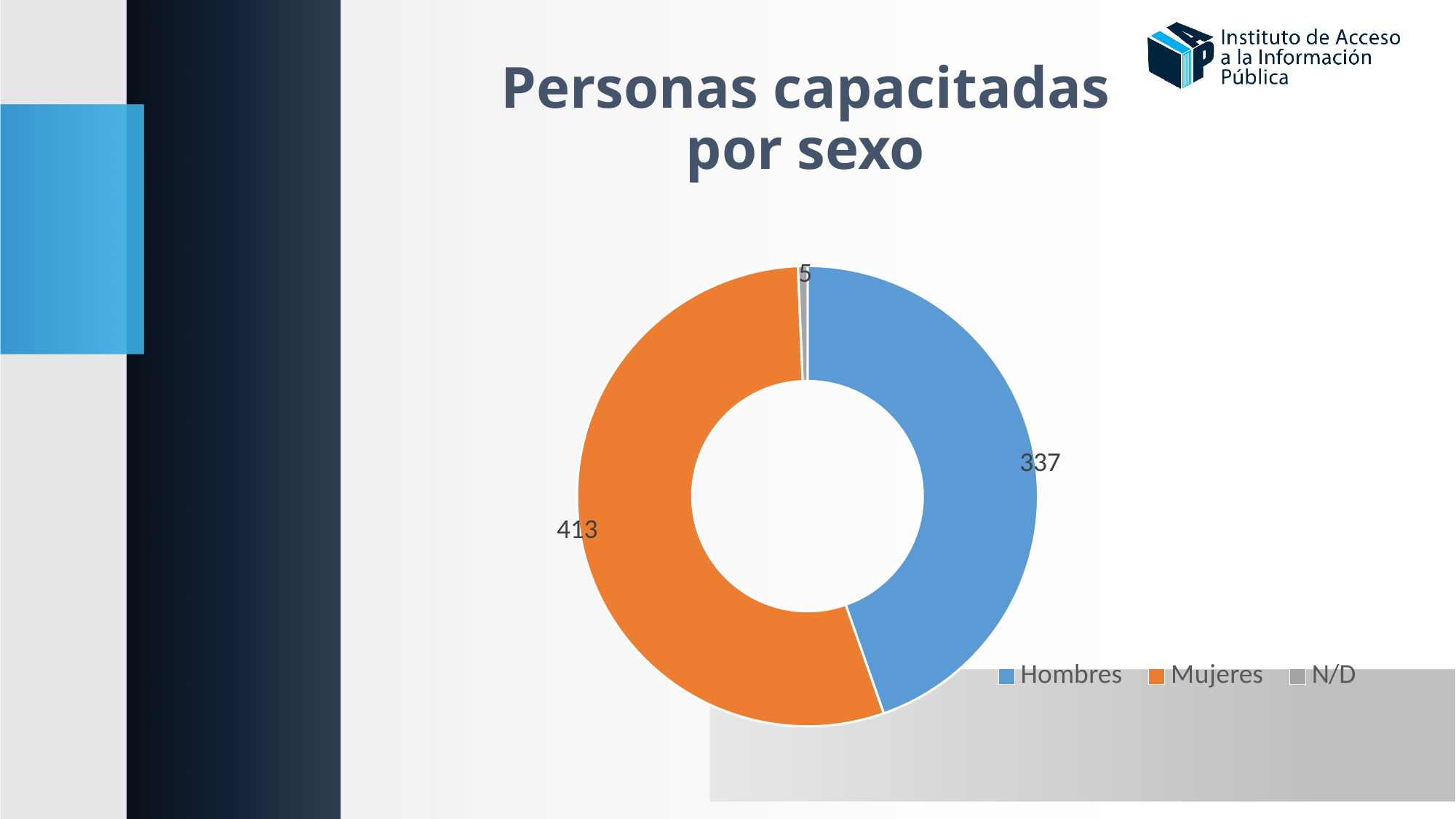
What is the value for Hombres? 337 What is the value for N/D? 5 Which category has the lowest value? N/D What is the value for Mujeres? 413 What is the difference between the values for Mujeres and Hombres? 76 Which category has the highest value? Mujeres Which is larger, the value for Hombres or the value for Mujeres? Mujeres What colour represents Mujeres in the chart? Orange What is the total of all the values shown in the chart? 755 How many categories does the chart show? 3 What is the title of the chart? Personas capacitadas por sexo What kind of chart is shown on the slide? Doughnut chart